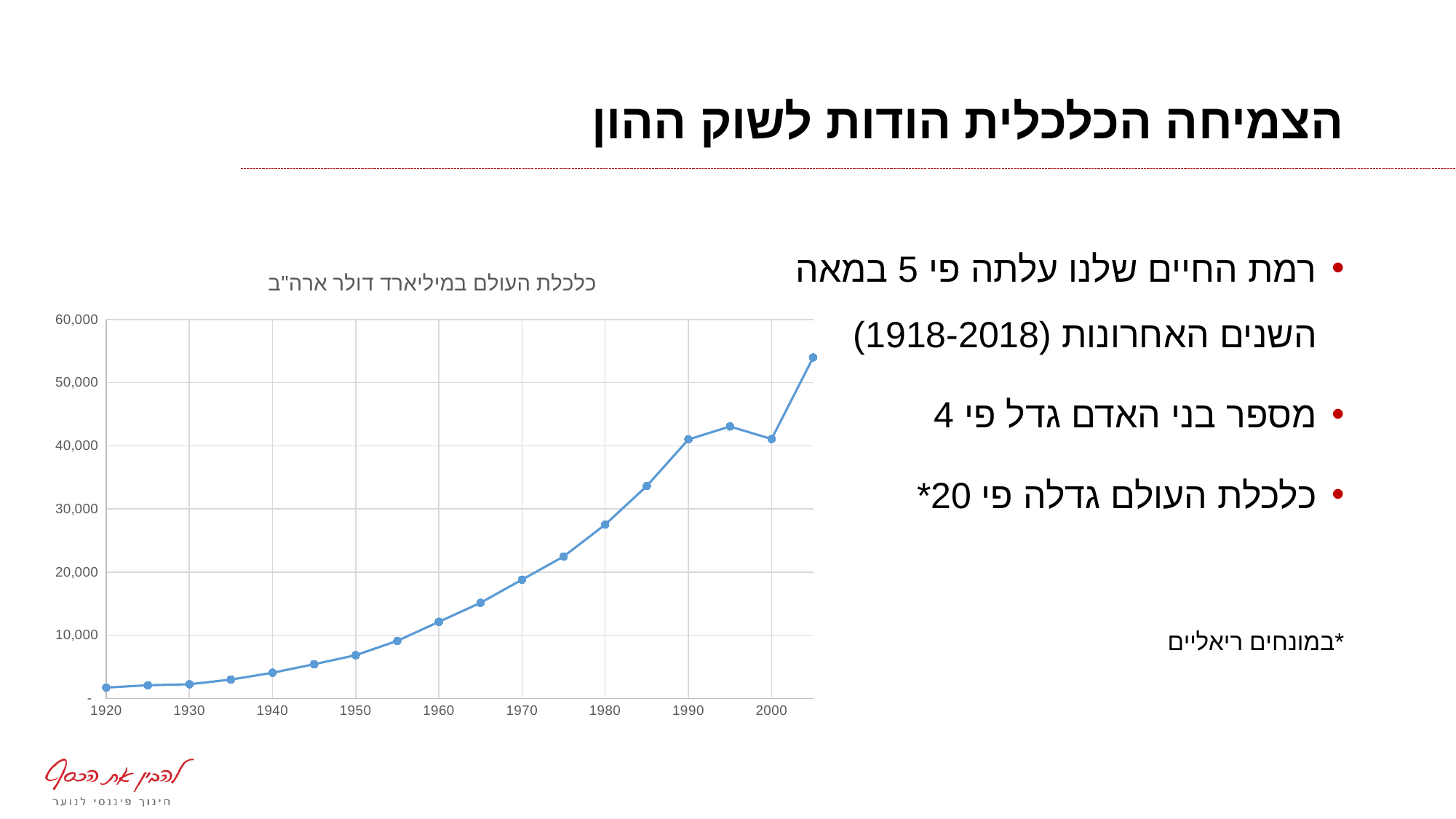
Is the value for 1980 greater or less than 30,000? less Is the value for 1960 greater or less than 20,000? less Do the values in the chart generally rise or fall from 1920 to 2005? rise What is the title of the chart? כלכלת העולם במיליארד דולר ארה"ב How many data points are plotted on the line? 18 Which year has the highest value in the chart? 2005 Which is larger, the value for 1970 or the value for 1950? 1970 What kind of chart is shown on the slide? line chart Is the value for 2005 greater or less than 50,000? greater Which year has the lowest value in the chart? 1920 Which is larger, the value for 1995 or the value for 2000? 1995